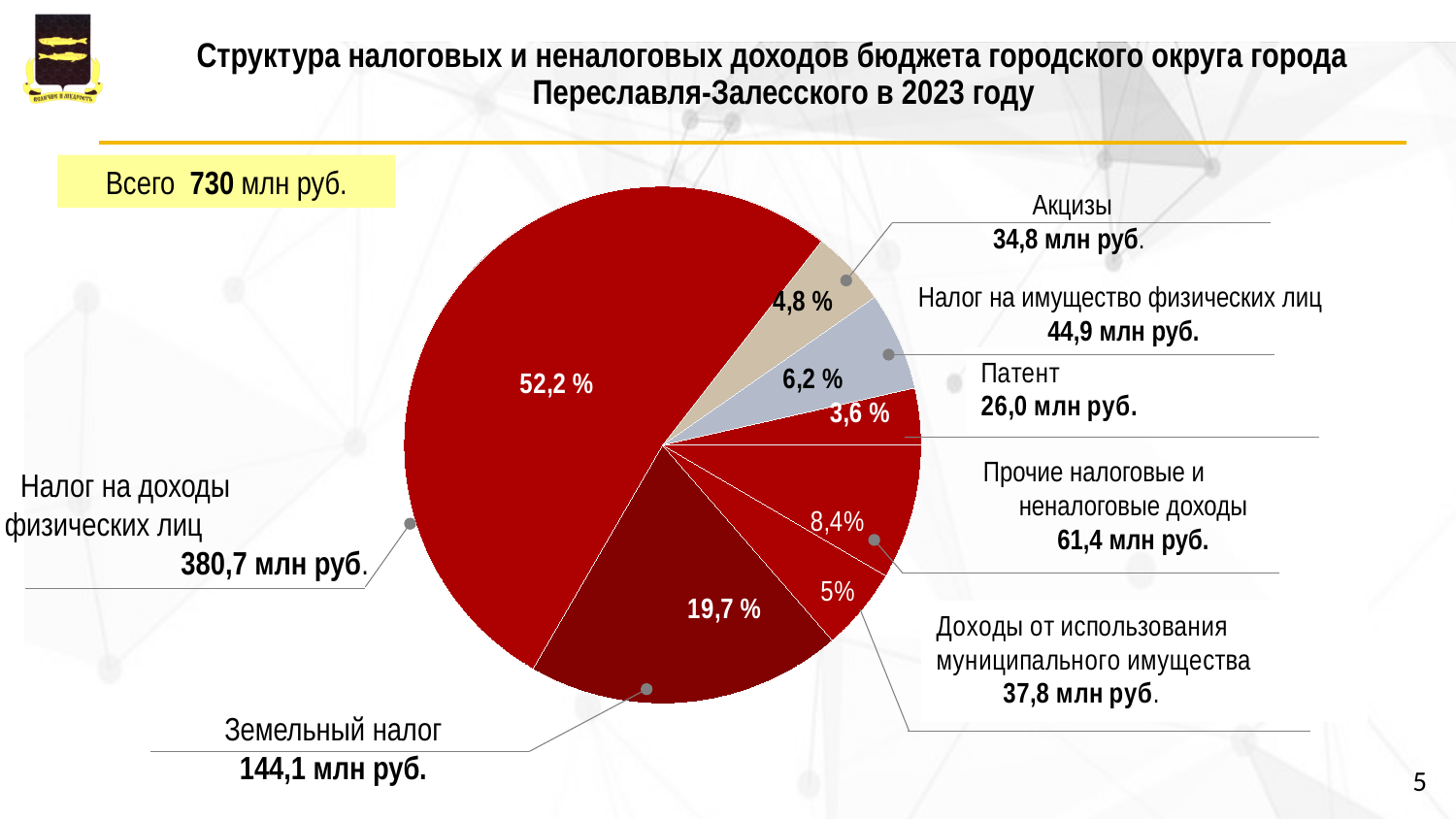
How many slices does the pie chart have? 7 What share of the pie does Земельный налог represent? 19,7 % What is the value for Земельный налог? 144,1 млн руб. Which category has the smallest slice of the pie? Патент What total amount is stated on the slide for all revenues? 730 млн руб. Which is larger: Прочие налоговые и неналоговые доходы or Доходы от использования муниципального имущества? Прочие налоговые и неналоговые доходы What is the value for Налог на доходы физических лиц? 380,7 млн руб. What type of chart is shown on the slide? pie chart What share of the pie does Акцизы represent? 4,8 % What is the value for Патент? 26,0 млн руб. Which category has the largest slice of the pie? Налог на доходы физических лиц What is the difference between Налог на доходы физических лиц and Земельный налог? 236,6 млн руб.